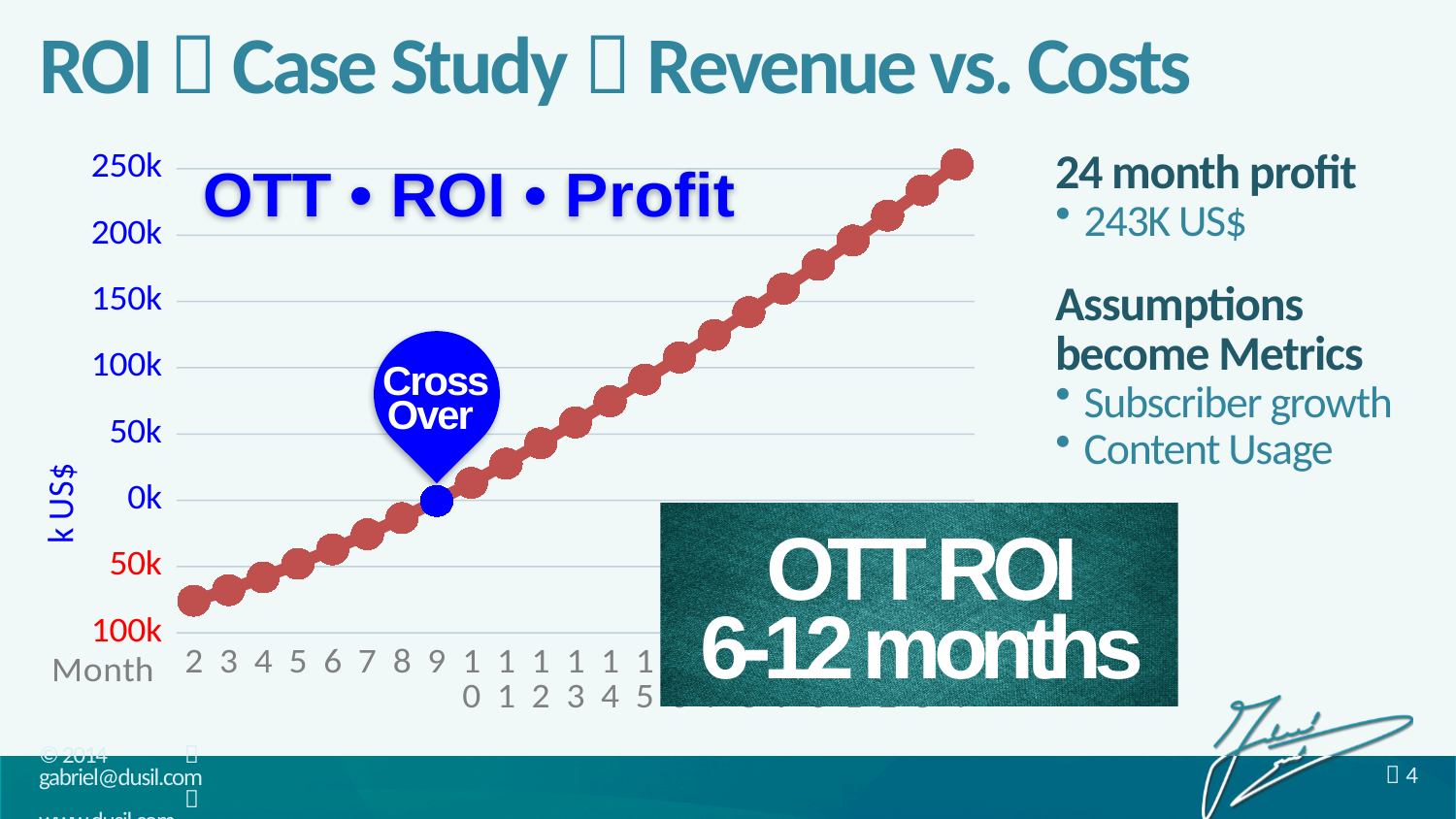
What is the highest tick value shown on the vertical axis? 250k What is the value at the 'Cross Over' point? 0k What is the title of the chart? OTT • ROI • Profit Which of the two is larger: the value at month 9 or the value at month 15? month 15 At which month does the 'Cross Over' point occur? 9 Is the value for month 2 greater or less than 100k on the negative side (i.e., above the bottom 100k tick)? greater Is the highest plotted value greater or less than 200k? greater What kind of chart is shown on the slide? line chart Is the value for month 5 greater or less than 0k? less Do the plotted values rise or fall as the month increases along the x axis? rise What is the label on the vertical axis of the chart? k US$